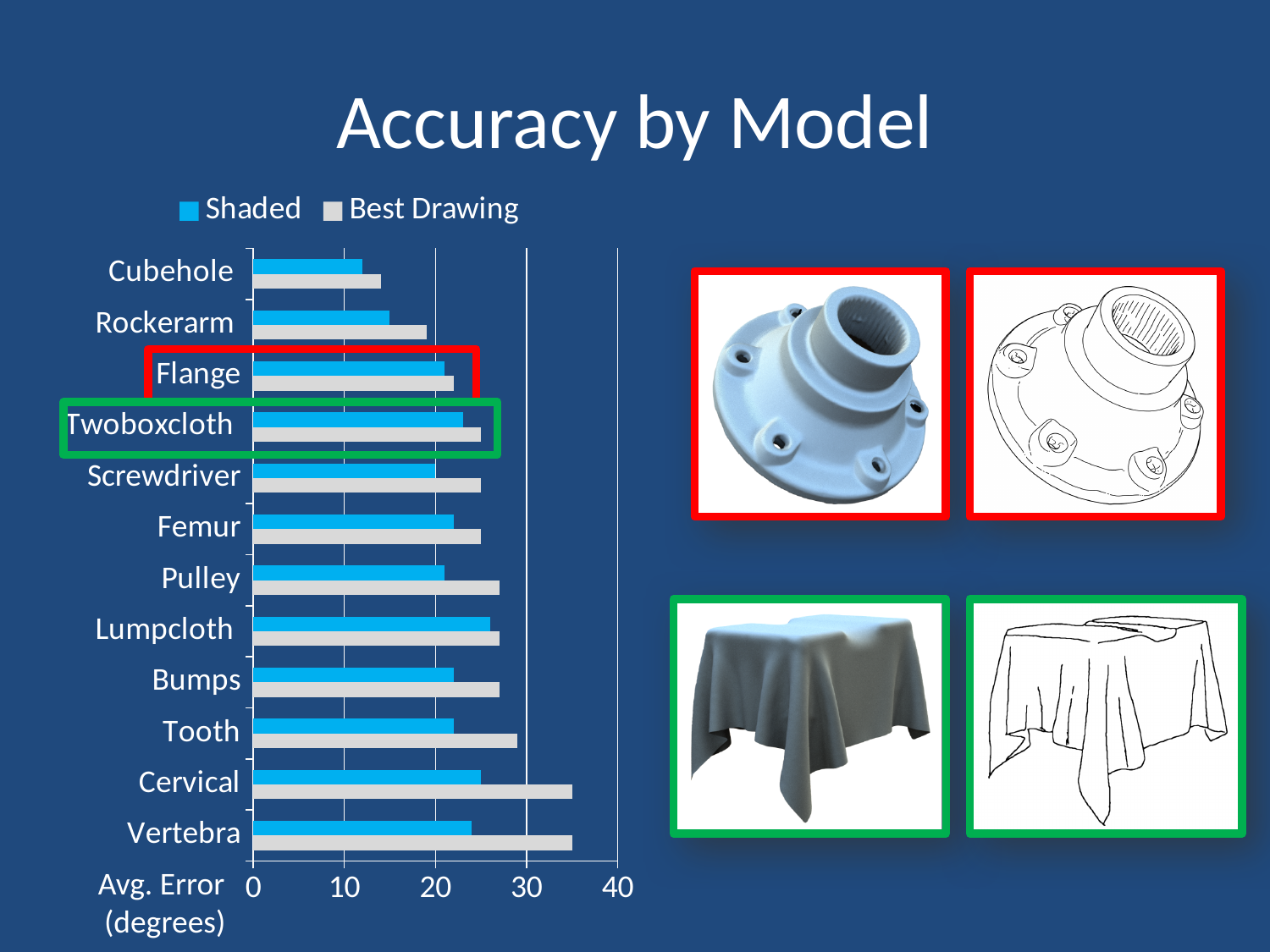
Which is larger: the Best Drawing value for Vertebra or the Best Drawing value for Cubehole? Vertebra Which model has the lowest Best Drawing value? Cubehole What is the label of the horizontal axis of the chart? Avg. Error (degrees) Is the Best Drawing value for Cervical greater or less than 30? greater Which model has the lowest Shaded value? Cubehole How many series does the chart legend list? 2 Is the Best Drawing value for Pulley greater or less than 20? greater Is the Shaded value for Cubehole greater or less than 20? less What kind of chart is shown on the slide? bar chart What is the title of the chart on the slide? Accuracy by Model For Cervical, which is larger: the Shaded value or the Best Drawing value? Best Drawing How many models (categories) are listed on the chart? 12